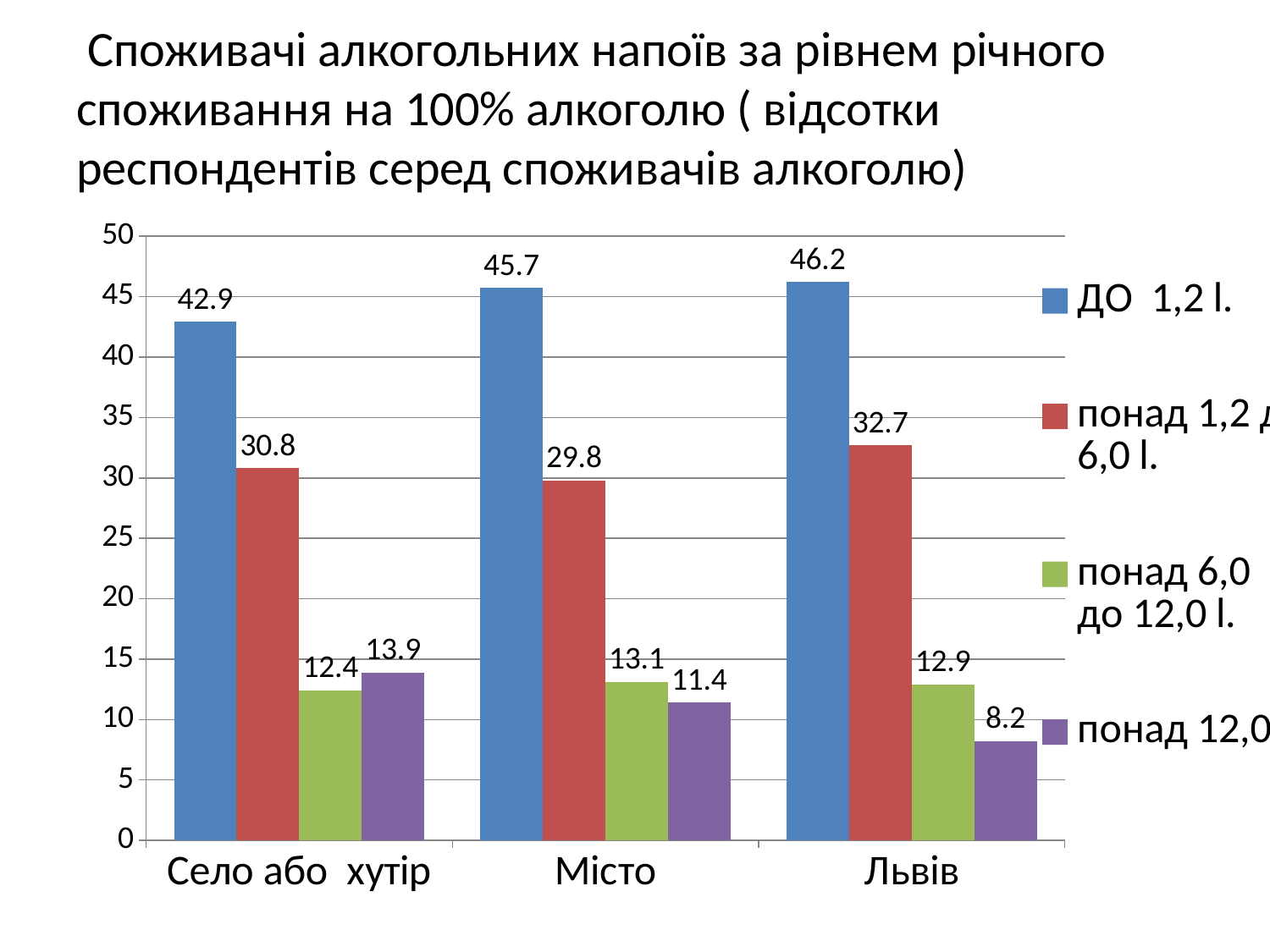
Which category has the lowest value for the "понад 1,2 до 6,0 l." series? Місто What is the value for "понад 6,0 до 12,0 l." in the "Село або хутір" category? 12.4 What kind of chart is shown on the slide? bar chart What is the value for "ДО 1,2 l." in the "Львів" category? 46.2 Which is larger in the "Село або хутір" category: the "понад 6,0 до 12,0 l." bar or the purple bar? the purple bar What is the value for "понад 1,2 до 6,0 l." in the "Місто" category? 29.8 Is the value for "понад 1,2 до 6,0 l." in "Львів" greater or less than 30? greater How many series does the legend list? 4 What colour are the bars for the "ДО 1,2 l." series? blue How many categories are shown on the x axis? 3 What is the difference between the "ДО 1,2 l." values for "Місто" and "Село або хутір"? 2.8 Which category has the highest value for the "ДО 1,2 l." series? Львів